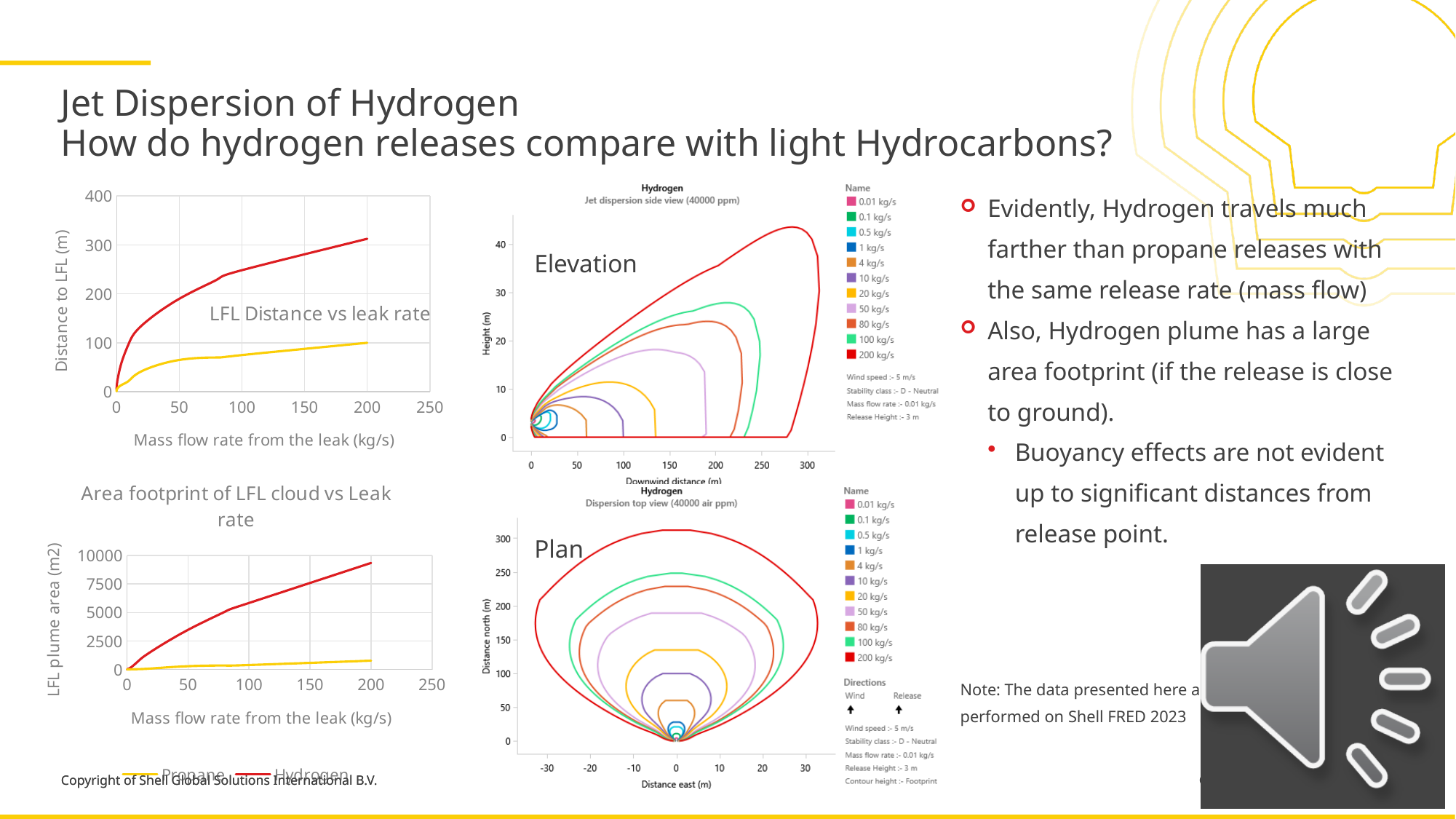
In the 'LFL Distance vs leak rate' chart, which series is higher at a mass flow rate of 200 kg/s, Propane or Hydrogen? Hydrogen In the 'LFL Distance vs leak rate' chart, is the Propane value at 100 kg/s greater or less than 100? less In the 'Area footprint of LFL cloud vs Leak rate' chart, which series has the larger plume area at 150 kg/s, Propane or Hydrogen? Hydrogen How many series does the legend at the bottom left of the slide list? 2 What colour is the Hydrogen series in the line charts on the left of the slide? red In the 'LFL Distance vs leak rate' chart, is the Hydrogen value at 200 kg/s greater or less than 200? greater What kind of chart is the 'LFL Distance vs leak rate' chart? line chart What is the x-axis title of the 'Area footprint of LFL cloud vs Leak rate' chart? Mass flow rate from the leak (kg/s) How many release rates are listed in the legend of the Hydrogen 'Jet dispersion side view' (Elevation) plot? 11 In the 'LFL Distance vs leak rate' chart, does the Hydrogen distance rise or fall as mass flow rate increases? rise In the 'Area footprint of LFL cloud vs Leak rate' chart, is the Propane value at 200 kg/s greater or less than 2500? less